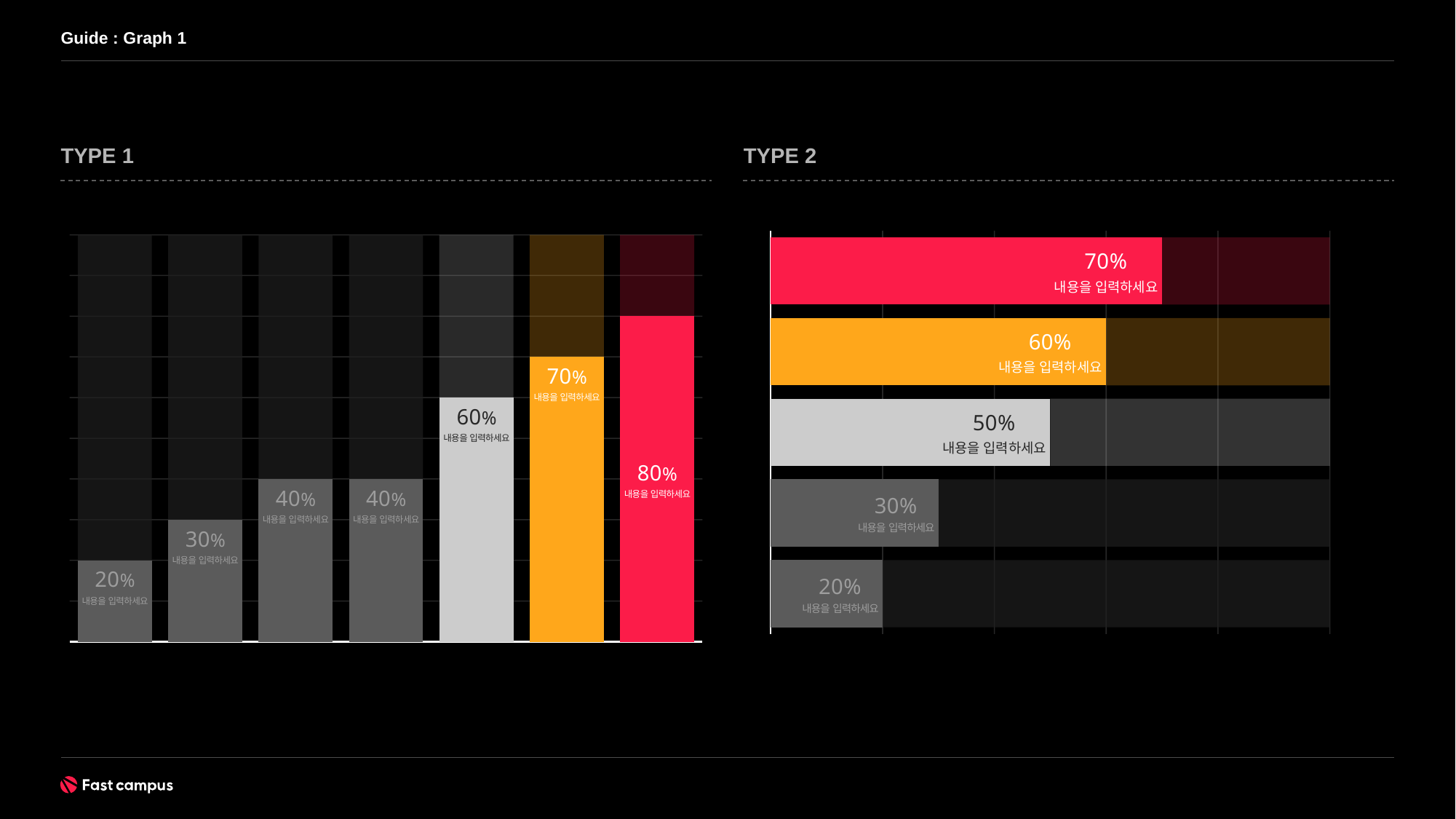
On the TYPE 1 chart, what is the difference between the red bar and the orange bar? 10% On the TYPE 1 chart, what is the value of the orange bar? 70% On the TYPE 2 chart, which is larger, the orange bar or the light grey bar? the orange bar On the TYPE 1 chart, what is the value of the rightmost (red) bar? 80% On the TYPE 1 chart, how many bars are plotted? 7 On the TYPE 1 chart, do the bar values generally rise or fall from left to right? rise On the TYPE 1 chart, what is the value of the leftmost bar? 20% On the TYPE 2 chart, what is the lowest value shown? 20% On the TYPE 1 chart, what kind of chart is shown? bar chart On the TYPE 2 chart, how many bars are plotted? 5 On the TYPE 2 chart, what is the value of the top (red) bar? 70% On the TYPE 1 chart, what is the highest value shown? 80%